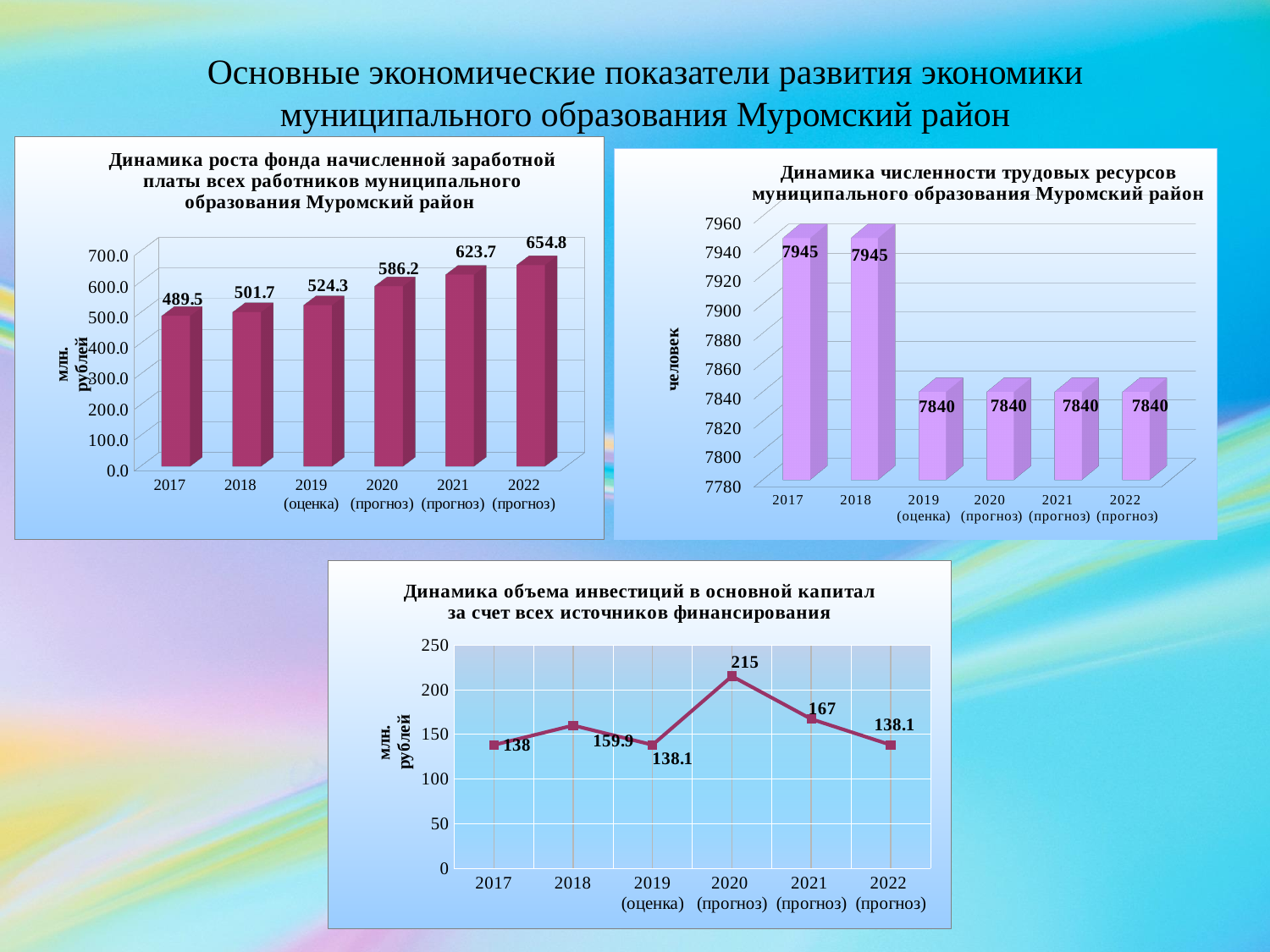
In the top-left chart (Динамика роста фонда начисленной заработной платы), what is the value for 2019 (оценка)? 524.3 In the bottom chart (Динамика объема инвестиций в основной капитал), which is larger, the value for 2018 or the value for 2021? 2021 In the top-left chart (Динамика роста фонда начисленной заработной платы), do the values rise or fall from 2017 to 2022? rise In the bottom chart (Динамика объема инвестиций в основной капитал), what is the value for 2020 (прогноз)? 215 In the top-left chart (Динамика роста фонда начисленной заработной платы), what is the difference between the 2022 and 2017 values? 165.3 In the top-right chart (Динамика численности трудовых ресурсов), how many years are shown on the x axis? 6 In the top-right chart (Динамика численности трудовых ресурсов), what is the difference between the 2018 and 2019 values? 105 In the bottom chart (Динамика объема инвестиций в основной капитал), which year has the highest value? 2020 (прогноз) In the top-right chart (Динамика численности трудовых ресурсов), what kind of chart is it? bar chart In the top-left chart (Динамика роста фонда начисленной заработной платы), which year has the highest value? 2022 (прогноз) In the top-right chart (Динамика численности трудовых ресурсов), what is the value for 2018? 7945 In the bottom chart (Динамика объема инвестиций в основной капитал), what kind of chart is it? line chart